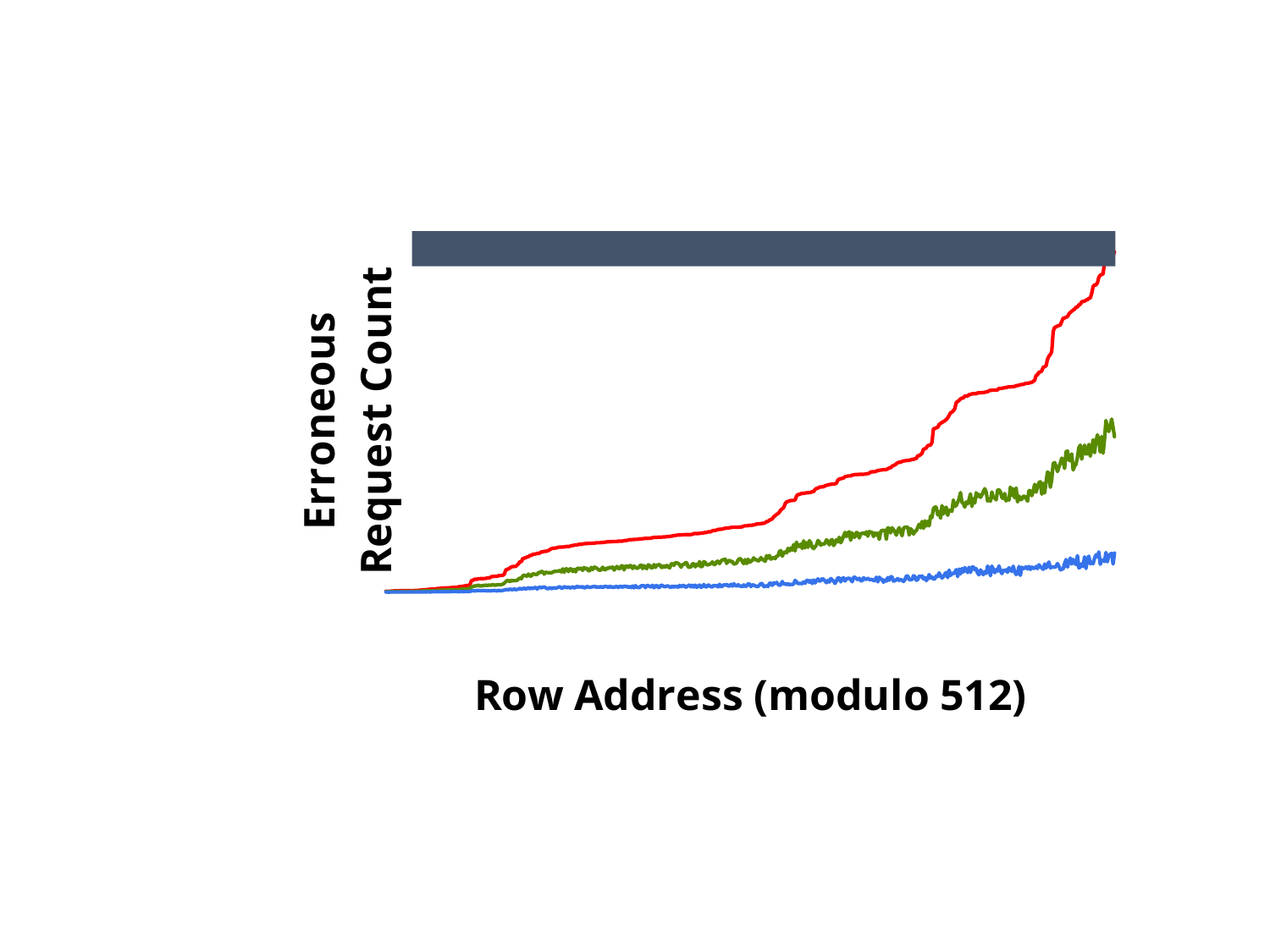
Does the red line rise or fall toward the right side of the chart? rise What is the label of the x axis? Row Address (modulo 512) Which coloured line stays lowest across the chart? blue Which coloured line reaches the highest erroneous request count at the right end of the chart? red Do the plotted values rise or fall as the row address increases along the x axis? rise What kind of chart is shown on the slide? line chart What is the label of the y axis? Erroneous Request Count How many lines are plotted on the chart? 3 At the right end of the chart, is the red line or the green line higher? red At the right end of the chart, is the green line or the blue line higher? green